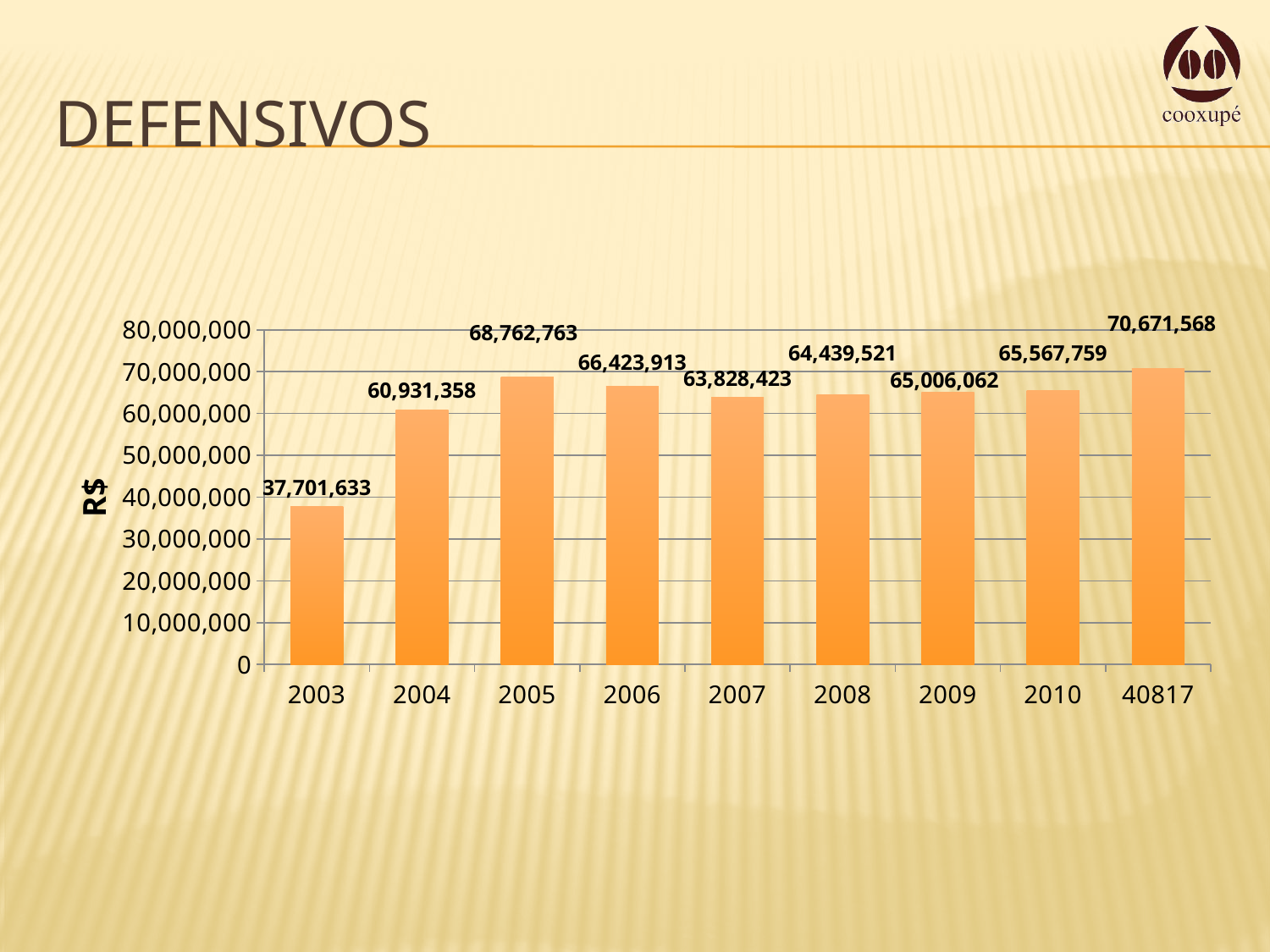
Which is larger, the value for 2005 or the value for 2006? 2005 What is the difference between the value for 40817 and the value for 2003? 32,969,935 Is the value for 2003 greater or less than 40,000,000? less Which category has the highest value? 40817 What is the value for 2008? 64,439,521 What kind of chart is shown on the slide? bar chart What is the difference between the values for 2005 and 2004? 7,831,405 What is the value for the category labelled 40817? 70,671,568 Which year has the lowest value? 2003 What is the value for 2003? 37,701,633 What is the label on the vertical axis? R$ How many bars are shown in the chart? 9